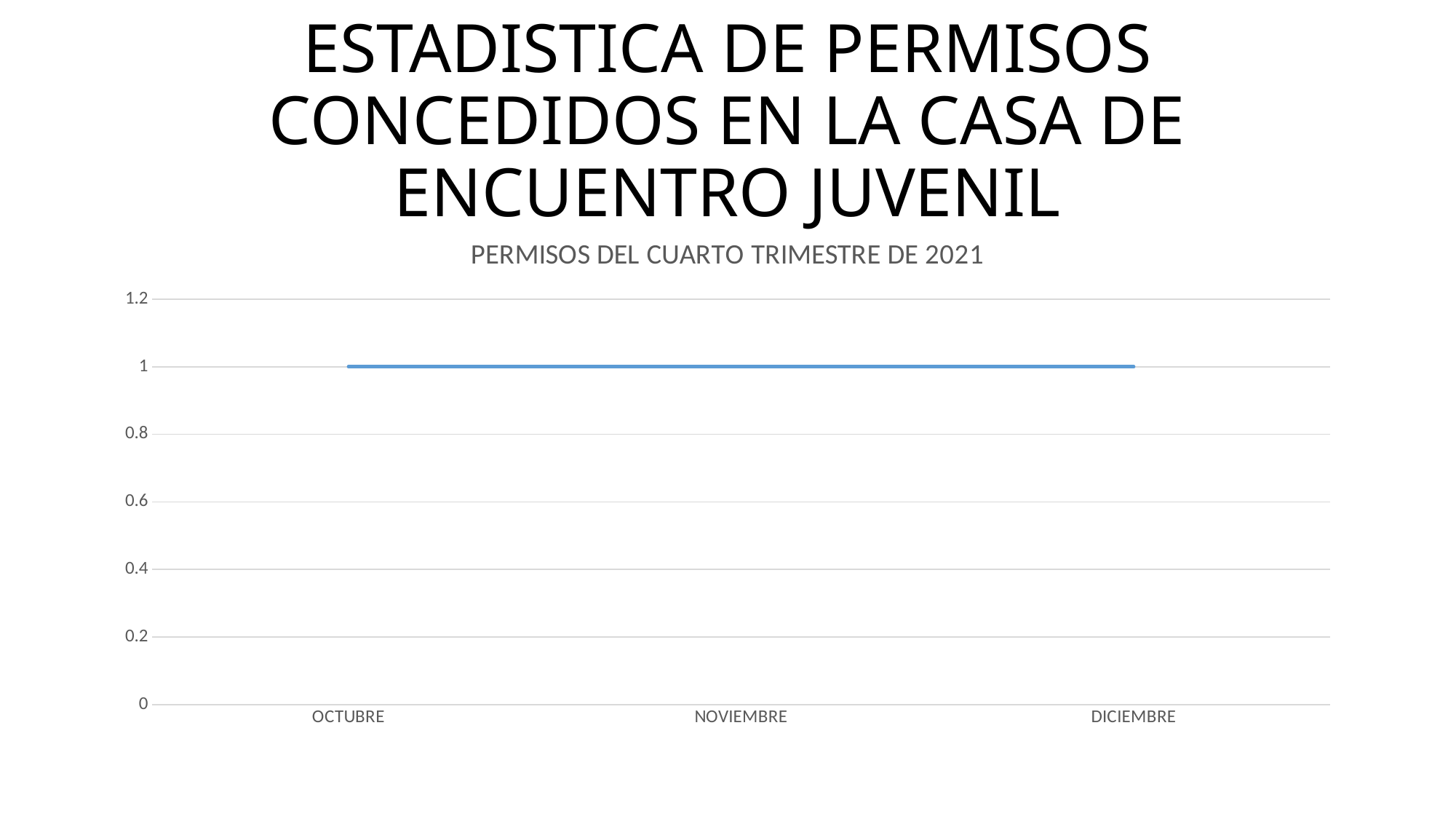
Do the values rise, fall or stay flat from OCTUBRE to DICIEMBRE? stay flat How many categories are shown on the x axis of the chart? 3 What is the highest value shown on the y axis of the chart? 1.2 What is the value for NOVIEMBRE in the chart? 1 What is the value for DICIEMBRE in the chart? 1 Which category is the first on the x axis of the chart? OCTUBRE What kind of chart is shown on the slide? line chart Is the value for NOVIEMBRE greater or less than 0.8? greater What is the value for OCTUBRE in the chart? 1 Is the value for DICIEMBRE greater or less than 1.2? less What is the title of the chart? PERMISOS DEL CUARTO TRIMESTRE DE 2021